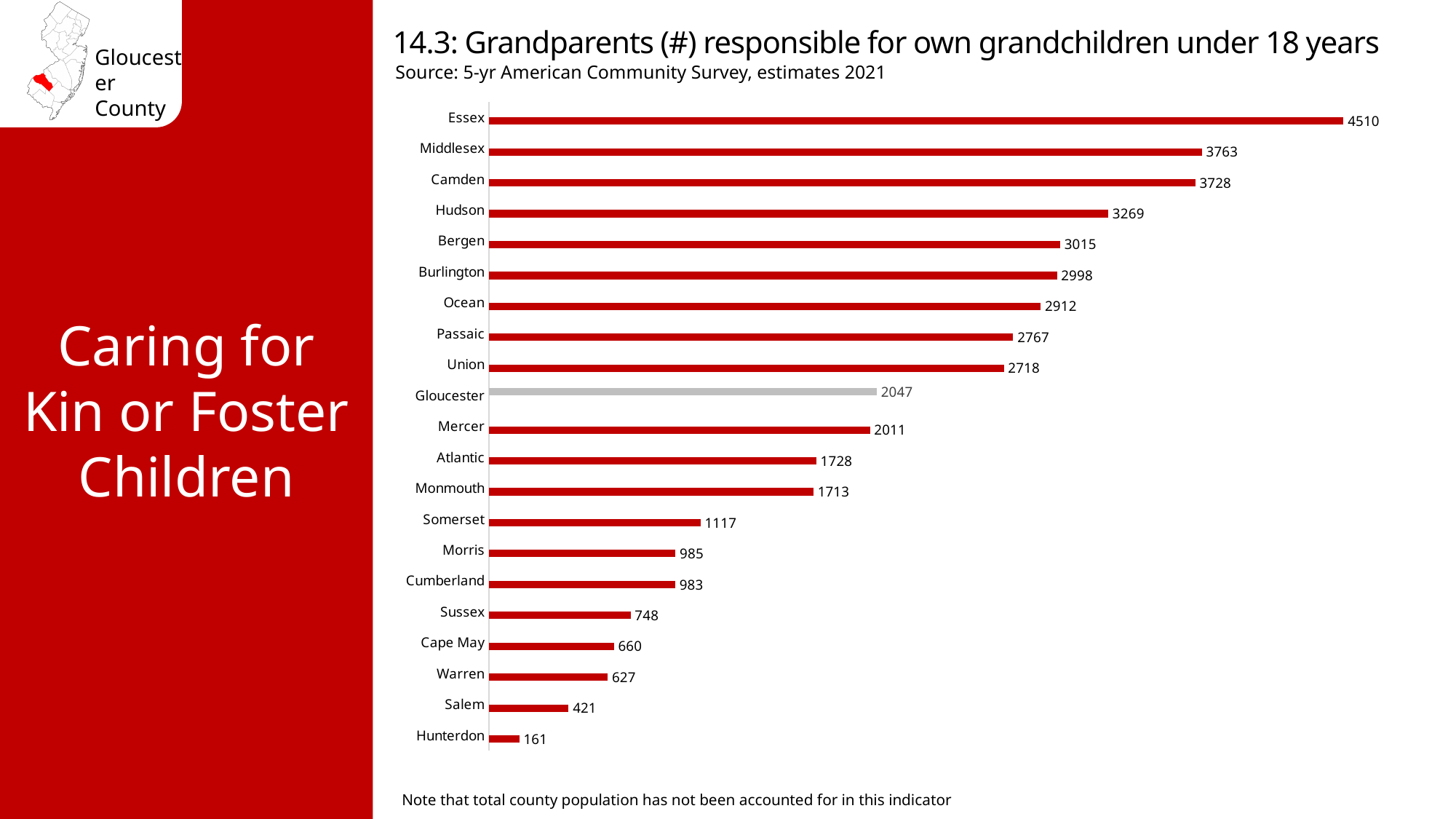
Which county has the lowest value? Hunterdon How many counties are shown in the chart? 21 Which is larger, the value for Sussex or the value for Cape May? Sussex What is the value for Camden? 3728 Which county has the highest number of grandparents responsible for own grandchildren? Essex What is the value for Hunterdon? 161 What is the difference between the values for Essex and Middlesex? 747 Which is larger, the value for Hudson or the value for Bergen? Hudson What is the difference between the values for Gloucester and Mercer? 36 What kind of chart is shown on the slide? Bar chart What is the value for Gloucester? 2047 Which county's bar is coloured grey instead of red? Gloucester